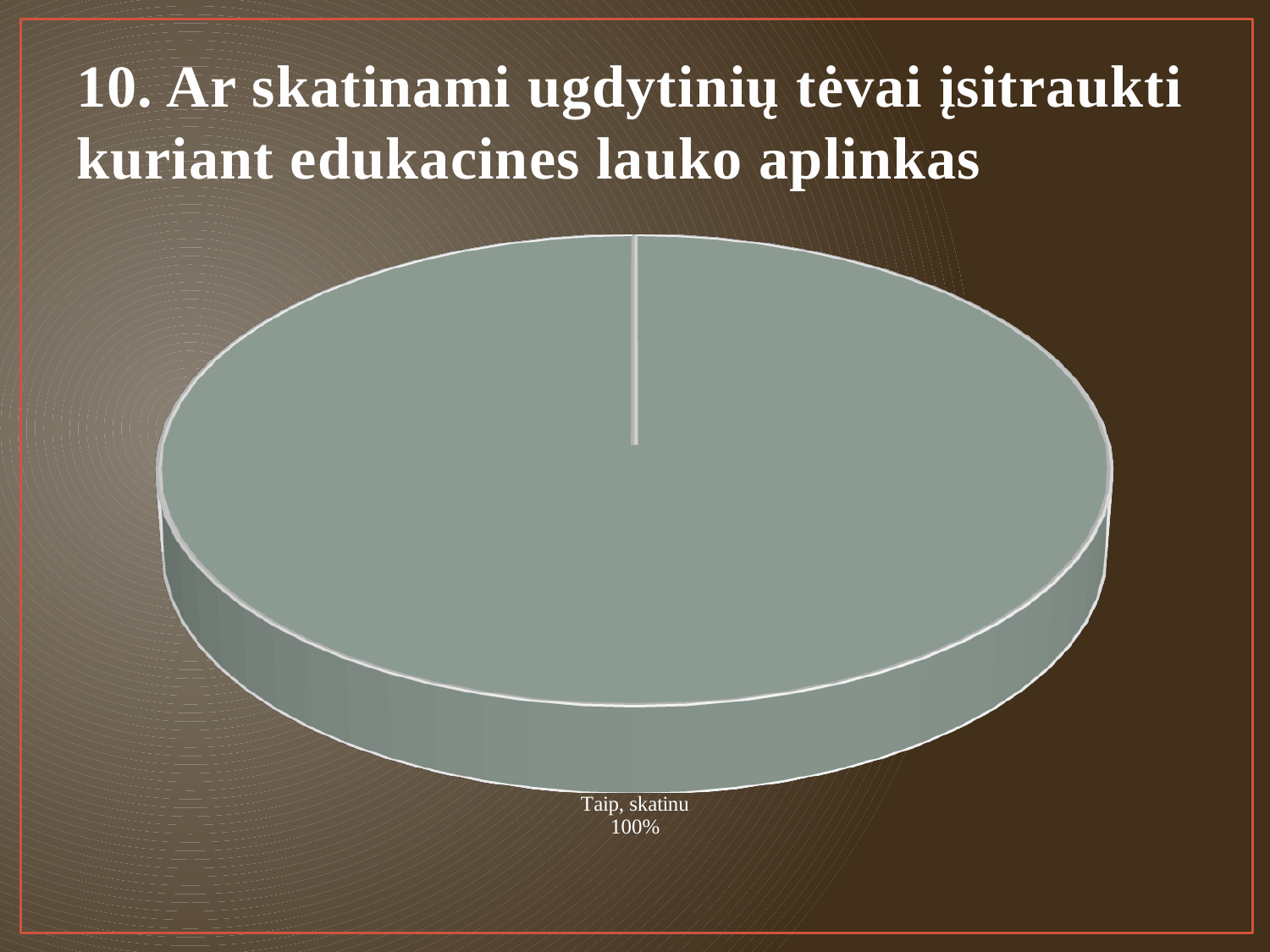
What is the label of the only slice in the pie chart? Taip, skatinu What is the value printed for the "Taip, skatinu" slice? 100% Which category makes up the largest share of the pie? Taip, skatinu How many slices does the pie chart have? 1 What kind of chart is shown on the slide? Pie chart What share of the pie does the "Taip, skatinu" slice represent? 100% What is the title of the slide containing the pie chart? 10. Ar skatinami ugdytinių tėvai įsitraukti kuriant edukacines lauko aplinkas